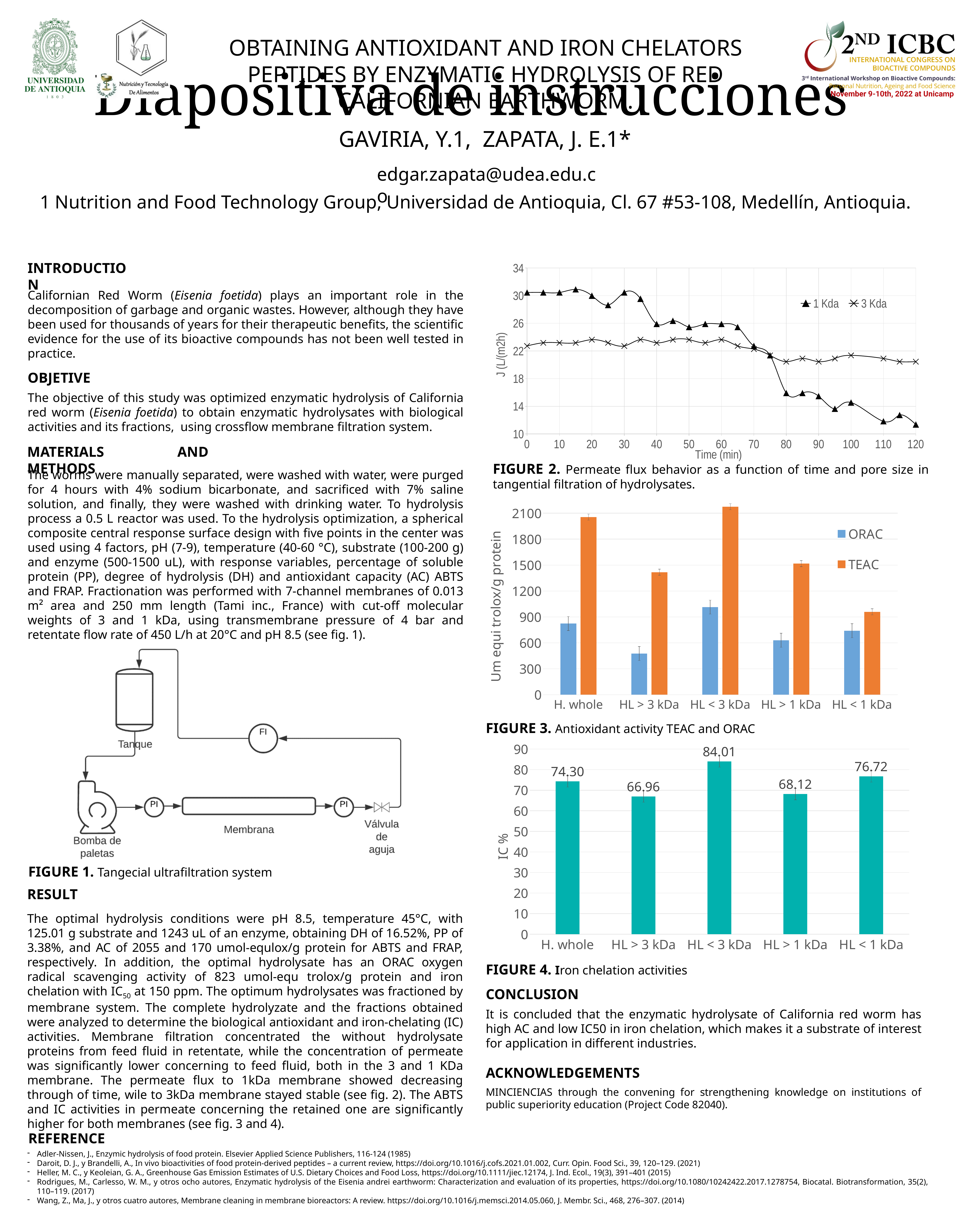
In the chart titled FIGURE 4 (Iron chelation activities), which category has the highest IC % value? HL < 3 kDa In the chart titled FIGURE 3 (Antioxidant activity TEAC and ORAC), which category has the highest TEAC value? HL < 3 kDa In the chart titled FIGURE 3 (Antioxidant activity TEAC and ORAC), how many series does the legend list? 2 In the chart titled FIGURE 4 (Iron chelation activities), what is the IC % value for H. whole? 74,30 In the chart titled FIGURE 4 (Iron chelation activities), what is the IC % value for HL < 3 kDa? 84,01 In the chart titled FIGURE 4 (Iron chelation activities), which category has the lowest IC % value? HL > 3 kDa In the chart titled FIGURE 4 (Iron chelation activities), how many categories are shown on the x axis? 5 What kind of chart is FIGURE 2 (Permeate flux behavior as a function of time and pore size)? line chart In the chart titled FIGURE 2 (Permeate flux behavior), does the 1 Kda series rise or fall as time increases from 0 to 120 min? fall In the chart titled FIGURE 4 (Iron chelation activities), what is the difference between the IC % values for HL < 3 kDa and HL > 3 kDa? 17,05 In the chart titled FIGURE 3 (Antioxidant activity TEAC and ORAC), is the ORAC value for HL > 3 kDa greater or less than 600? less In the chart titled FIGURE 3 (Antioxidant activity TEAC and ORAC), which is larger for HL < 1 kDa, the ORAC value or the TEAC value? TEAC